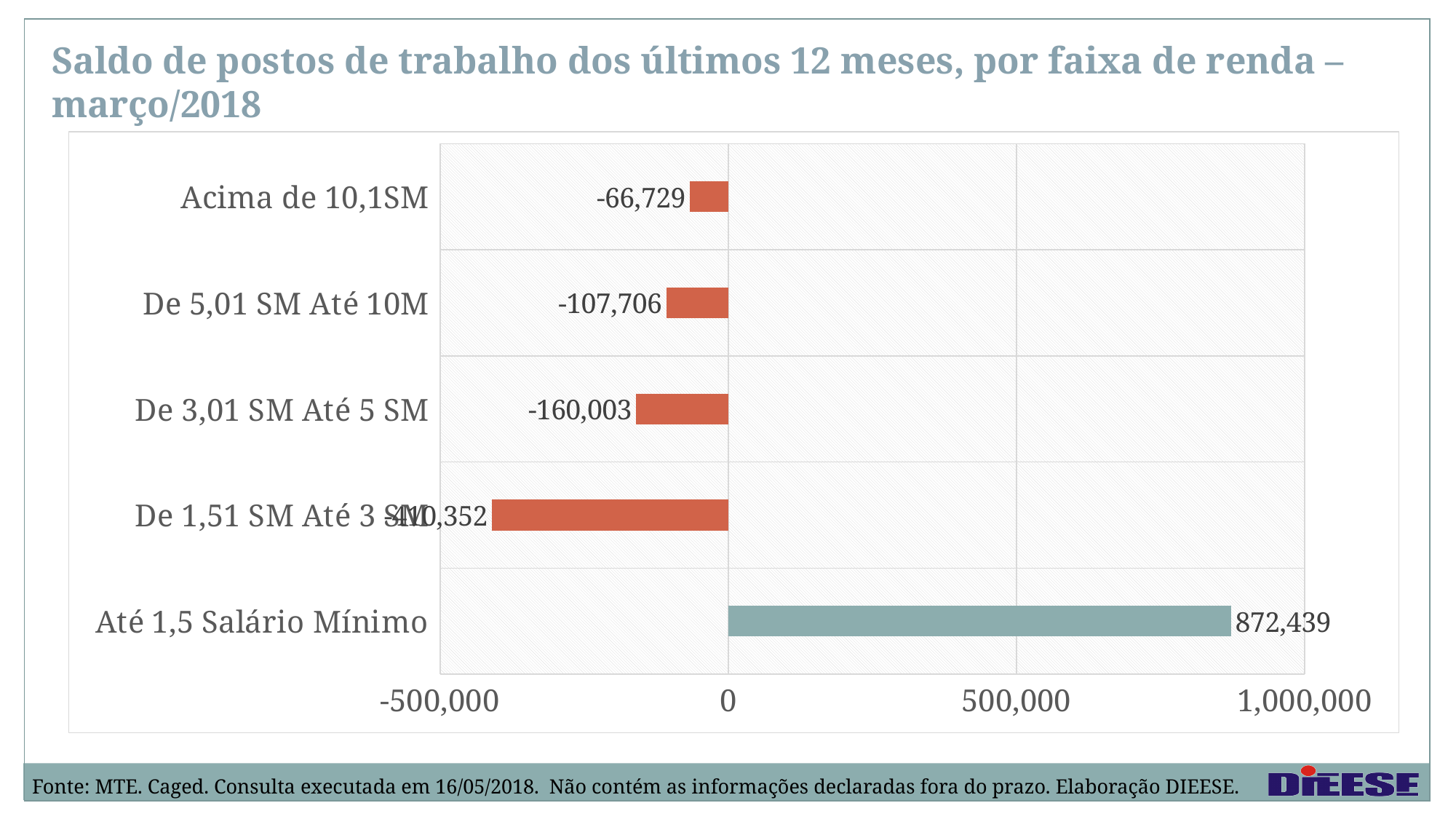
Which is larger, the value for "De 5,01 SM Até 10M" or the value for "De 3,01 SM Até 5 SM"? De 5,01 SM Até 10M Is the value for "Até 1,5 Salário Mínimo" greater or less than 500,000? greater What is the difference between the values for "Até 1,5 Salário Mínimo" and "De 3,01 SM Até 5 SM"? 1,032,442 How many income brackets are shown in the chart? 5 What kind of chart is shown on the slide? bar chart What is the value for "De 5,01 SM Até 10M"? -107,706 What is the value for "Até 1,5 Salário Mínimo"? 872,439 Which income bracket has the lowest value? De 1,51 SM Até 3 SM What is the value for "De 3,01 SM Até 5 SM"? -160,003 What is the value for "Acima de 10,1SM"? -66,729 Which income bracket has the highest value? Até 1,5 Salário Mínimo What is the difference between the values for "Acima de 10,1SM" and "De 5,01 SM Até 10M"? 40,977